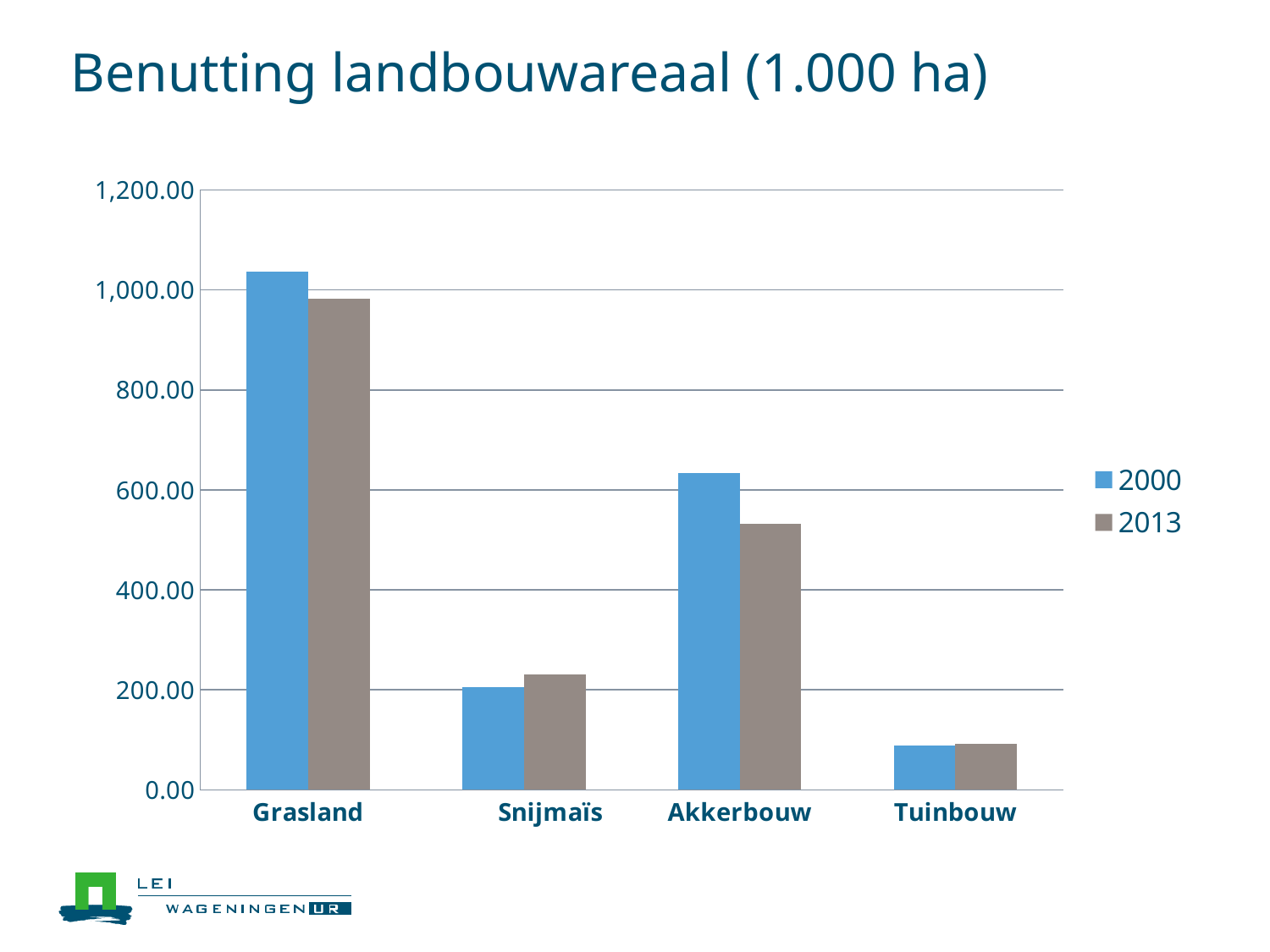
What kind of chart is shown on the slide? bar chart Which category has the highest value for 2000? Grasland Is the value for Tuinbouw in 2000 greater or less than 200.00? less For Snijmaïs, which is larger: the value for 2000 or the value for 2013? 2013 For Akkerbouw, which is larger: the value for 2000 or the value for 2013? 2000 Is the value for Akkerbouw in 2013 greater or less than 600.00? less What is the title of the chart? Benutting landbouwareaal (1.000 ha) Which category has the lowest value for 2013? Tuinbouw Is the value for Grasland in 2000 greater or less than 1,000.00? greater How many categories are shown on the x axis? 4 How many series does the legend list? 2 For Grasland, which is larger: the value for 2000 or the value for 2013? 2000